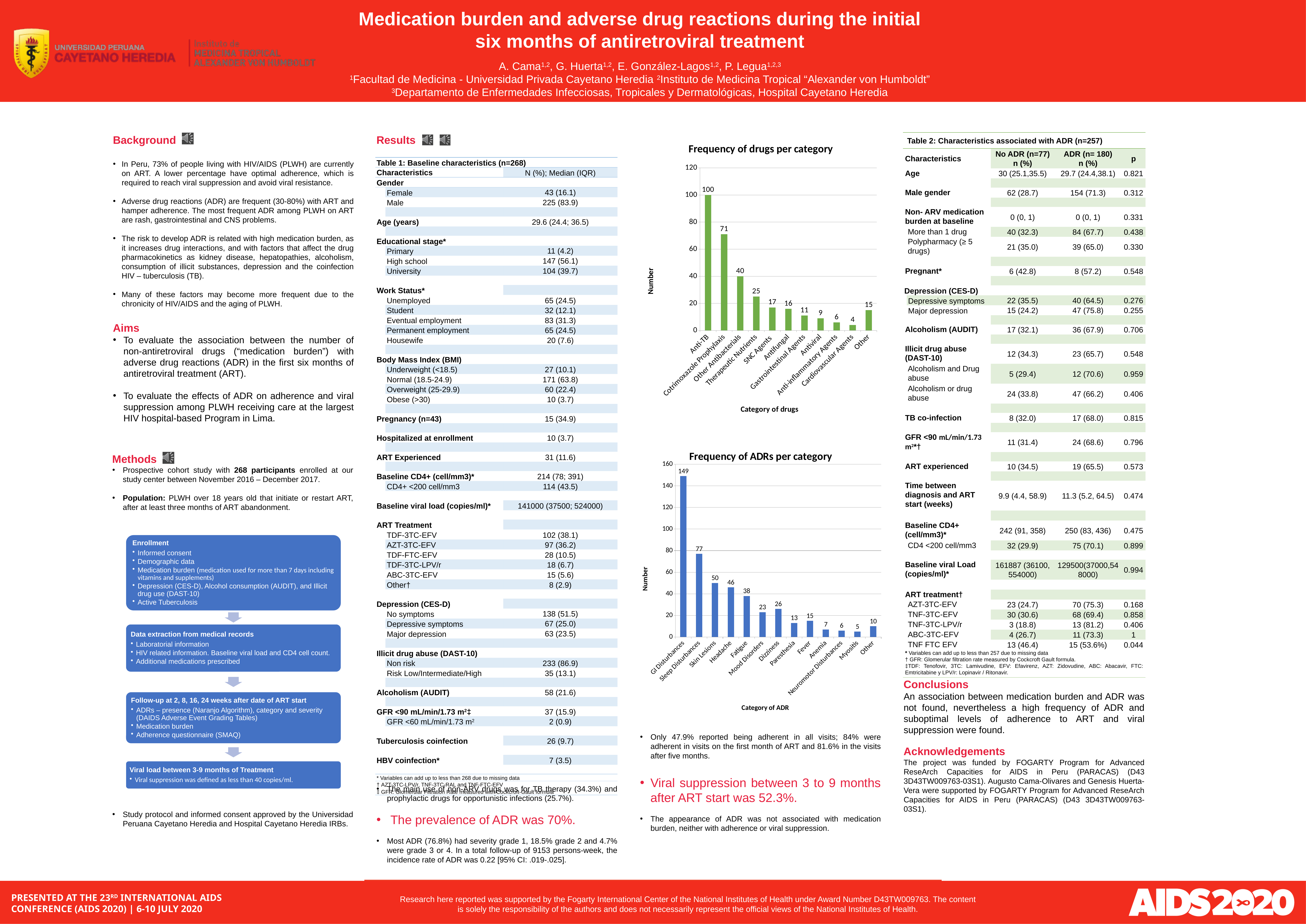
In the 'Frequency of drugs per category' chart, which category has the lowest value? Cardiovascular Agents In the 'Frequency of drugs per category' chart, what is the value for Cotrimoxazole Prophylaxis? 71 In the 'Frequency of drugs per category' chart, which is larger, Antifungal or Gastrointestinal Agents? Antifungal In the 'Frequency of drugs per category' chart, what is the value for Anti-TB? 100 What type of chart is the 'Frequency of ADRs per category' chart? Bar chart In the 'Frequency of ADRs per category' chart, which category has the highest value? GI Disturbances In the 'Frequency of ADRs per category' chart, what is the difference between Sleep Disturbances and Skin Lesions? 27 In the 'Frequency of ADRs per category' chart, what is the value for GI Disturbances? 149 In the 'Frequency of ADRs per category' chart, what is the value for Dizziness? 26 In the 'Frequency of drugs per category' chart, what is the difference between Other Antibacterials and Therapeutic Nutrients? 15 In the 'Frequency of ADRs per category' chart, how many ADR categories are shown? 13 In the 'Frequency of drugs per category' chart, how many drug categories are shown? 11